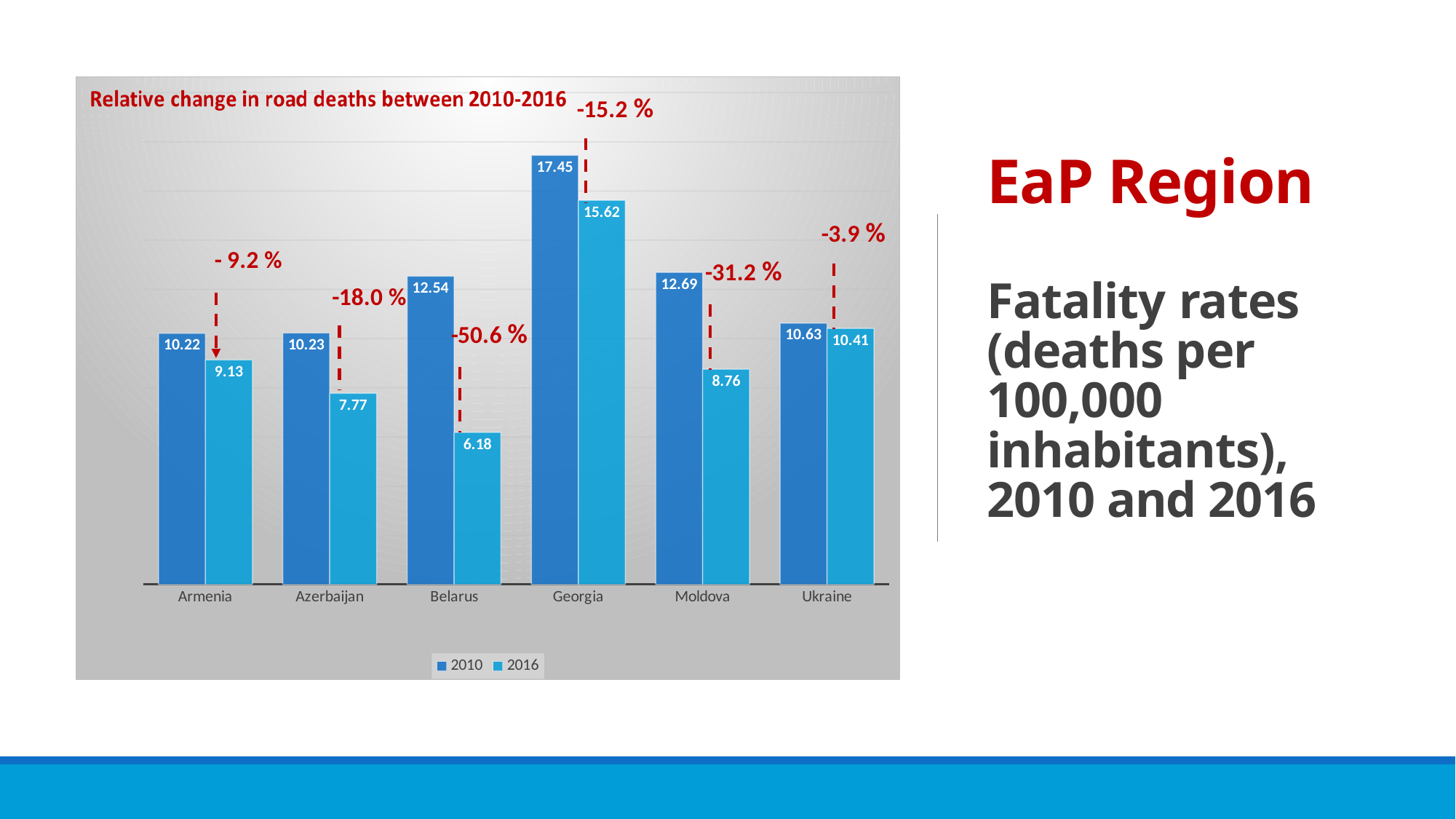
What is the 2016 fatality rate for Belarus? 6.18 What is the 2016 fatality rate for Moldova? 8.76 What is the 2010 fatality rate for Georgia? 17.45 How many series does the legend list? 2 What is the difference between the 2010 and 2016 fatality rates for Belarus? 6.36 What relative change in road deaths between 2010-2016 is shown for Belarus? -50.6 % Which is larger, the 2016 fatality rate for Ukraine or the 2016 fatality rate for Armenia? Ukraine What are the two series listed in the legend? 2010 and 2016 What kind of chart is shown on the slide? Bar chart Which country has the lowest 2016 fatality rate? Belarus Which country has the highest 2010 fatality rate? Georgia How many countries are shown on the chart? 6